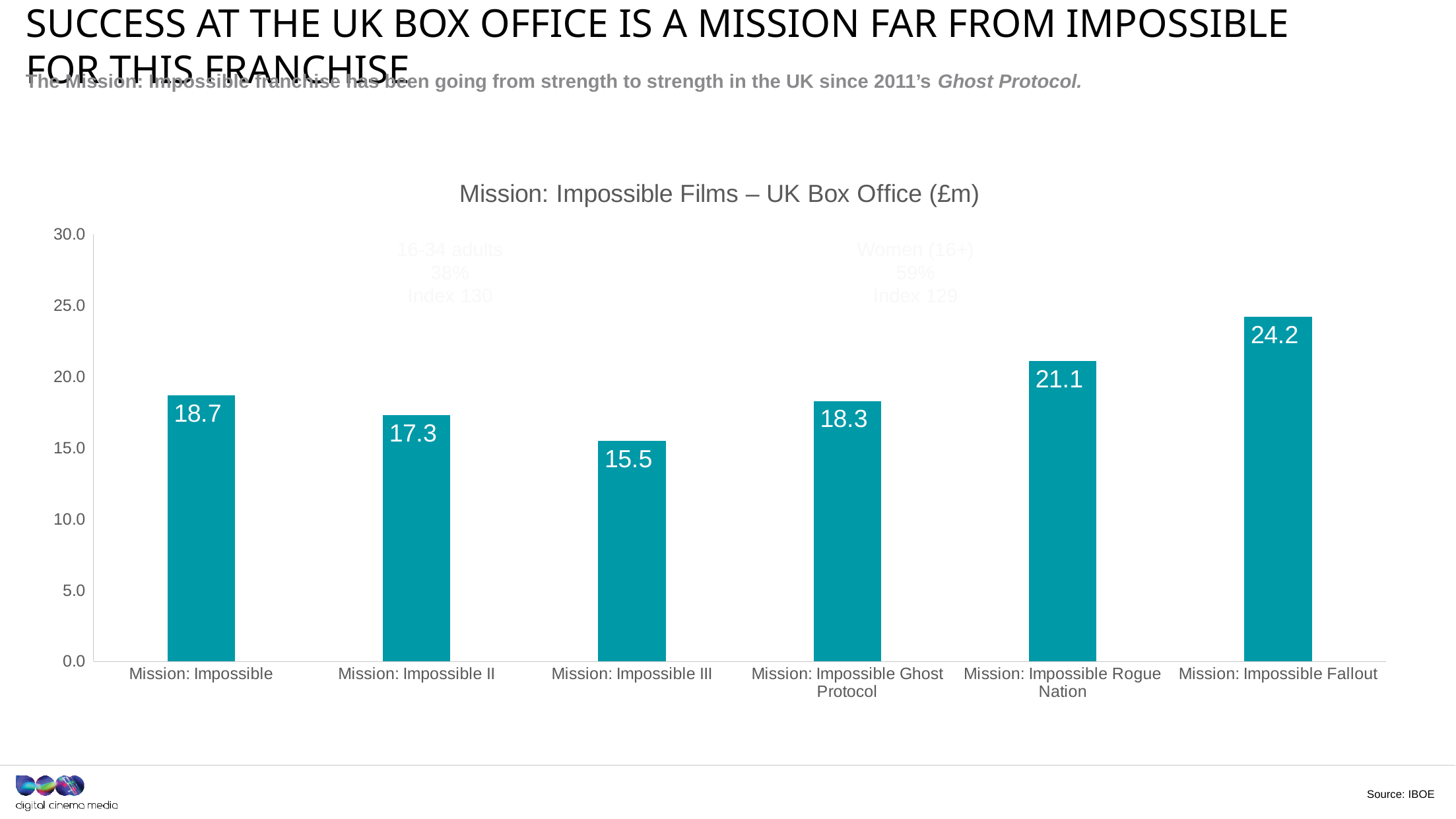
How many films are shown in the chart? 6 What is the difference in UK box office between Mission: Impossible Fallout and Mission: Impossible Rogue Nation? 3.1 What kind of chart is shown on the slide? bar chart What is the UK box office value for Mission: Impossible Ghost Protocol? 18.3 Which film has the lowest UK box office in the chart? Mission: Impossible III What is the UK box office value for Mission: Impossible Fallout? 24.2 What is the title of the chart? Mission: Impossible Films – UK Box Office (£m) Do the values rise or fall from Mission: Impossible III to Mission: Impossible Fallout? rise Is the value for Mission: Impossible Rogue Nation greater or less than 20.0? greater Which has the larger UK box office, Mission: Impossible or Mission: Impossible II? Mission: Impossible Which film has the highest UK box office in the chart? Mission: Impossible Fallout What is the UK box office value for Mission: Impossible III? 15.5